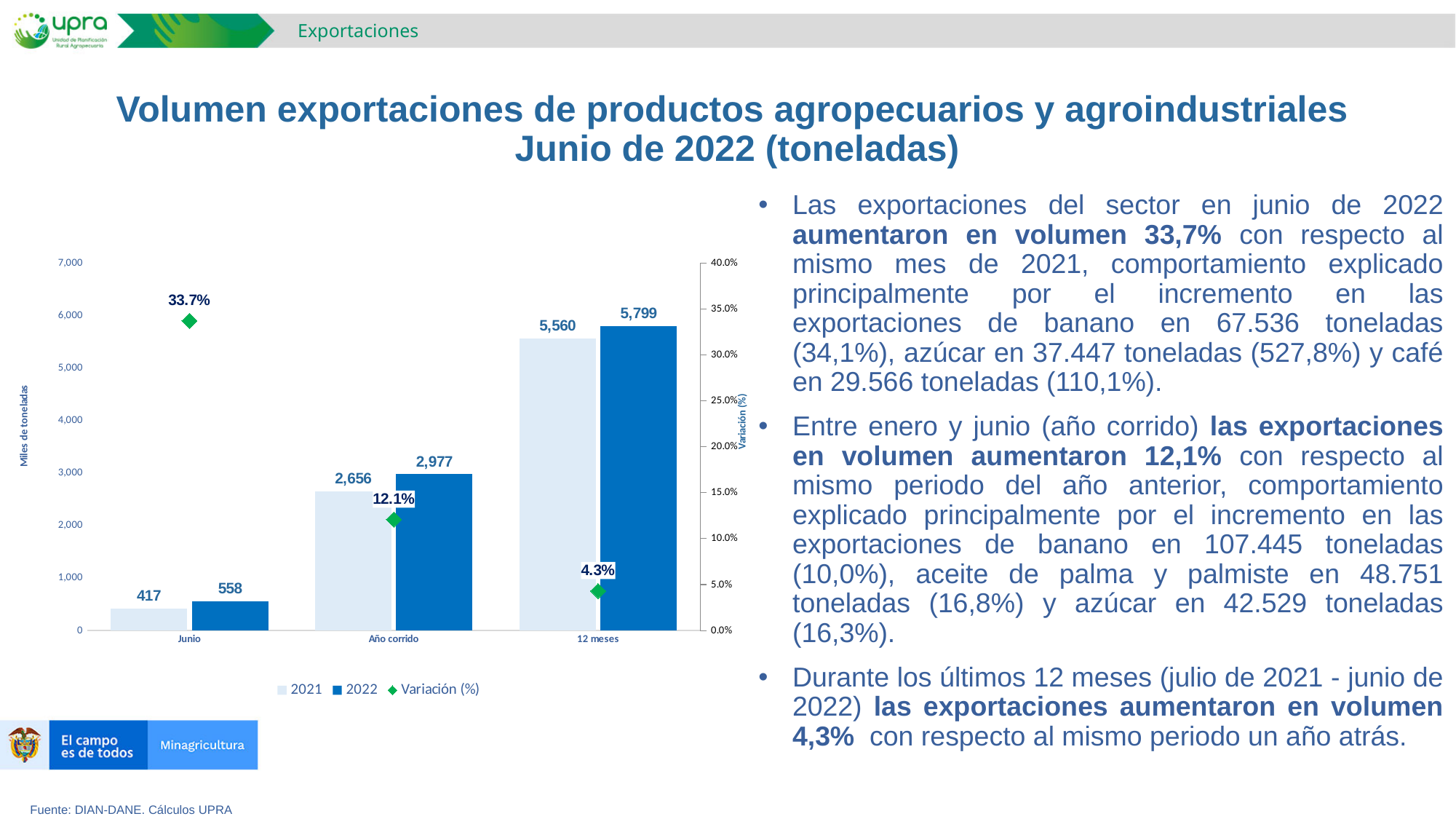
Which category has the lowest Variación (%) value? 12 meses What is the Variación (%) value for 12 meses? 4.3% What is the 2021 value for Año corrido? 2,656 How many series does the legend list? 3 What is the label of the left vertical axis? Miles de toneladas What is the difference between the 2022 and 2021 values for 12 meses? 239 What is the 2022 value for Junio? 558 What kind of chart is this? Combined bar and line (marker) chart Which is larger for Año corrido, the 2021 value or the 2022 value? 2022 How many categories are shown on the x axis? 3 Which category has the highest 2022 value? 12 meses Do the Variación (%) values rise or fall from Junio to 12 meses? Fall